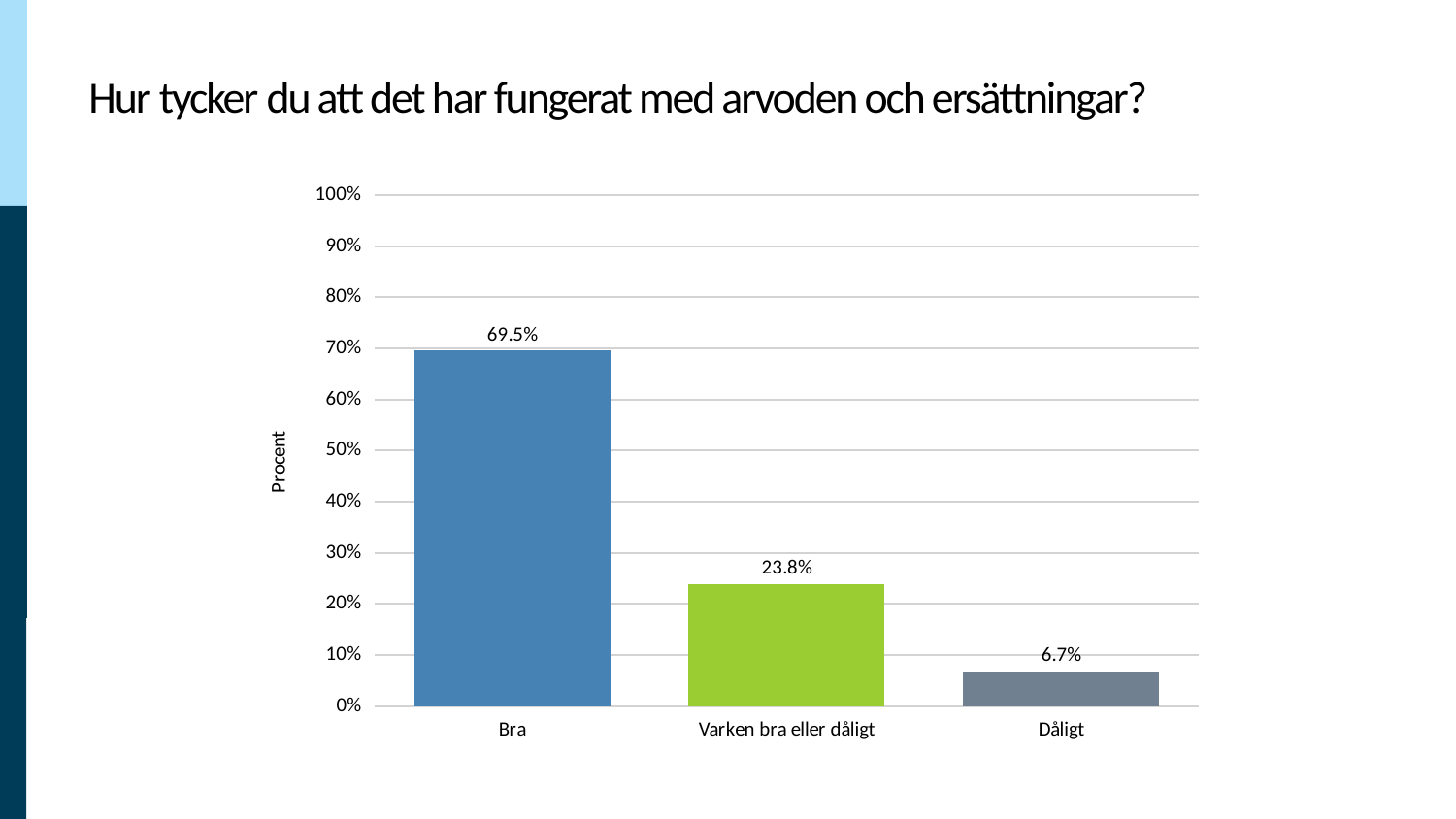
What is the label of the y axis? Procent What is the value for "Dåligt"? 6.7% What is the value for "Varken bra eller dåligt"? 23.8% How many categories are shown on the x axis? 3 Which category has the highest value? Bra What is the difference between the values for "Bra" and "Varken bra eller dåligt"? 45.7% Which is larger, the value for "Varken bra eller dåligt" or the value for "Dåligt"? Varken bra eller dåligt Which category has the lowest value? Dåligt What kind of chart is shown on the slide? bar chart What is the value for "Bra"? 69.5% Is the value for "Bra" greater or less than 60%? greater What is the difference between the values for "Varken bra eller dåligt" and "Dåligt"? 17.1%